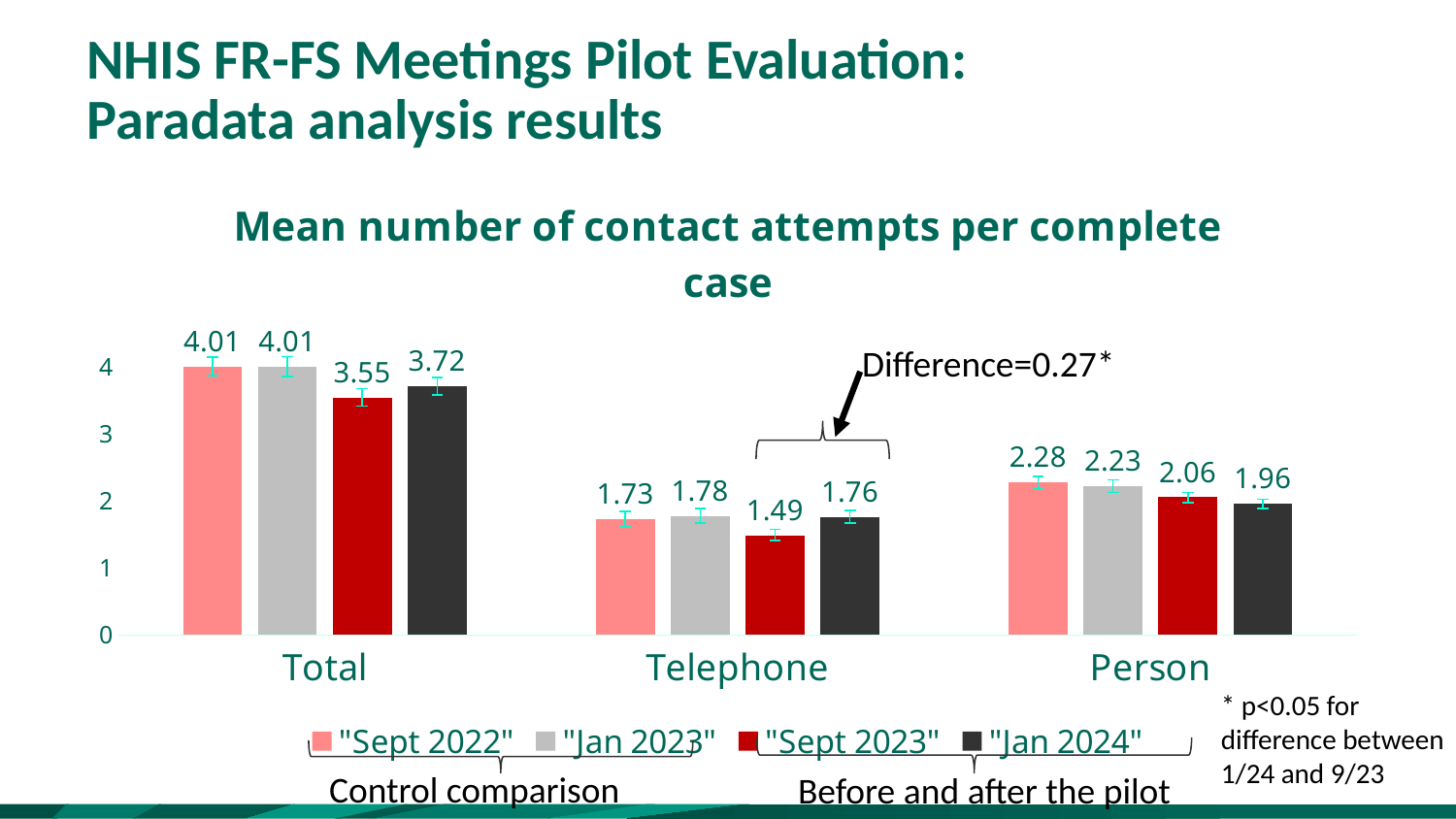
Which is larger for Total: the Sept 2023 value or the Jan 2024 value? Jan 2024 How many categories are shown on the x axis? 3 What is the mean number of contact attempts per complete case for Telephone in Sept 2023? 1.49 What kind of chart is shown on the slide? Bar chart What is the difference between the Jan 2024 and Sept 2023 values for Telephone? 0.27 What is the value for Person in Jan 2024? 1.96 Which category has the highest value for Jan 2024? Total What is the title of the chart? Mean number of contact attempts per complete case What is the difference between the Sept 2022 and Jan 2024 values for Person? 0.32 How many series does the legend list? 4 What is the value for Total in Sept 2023? 3.55 Which series has the lowest value for Telephone? Sept 2023